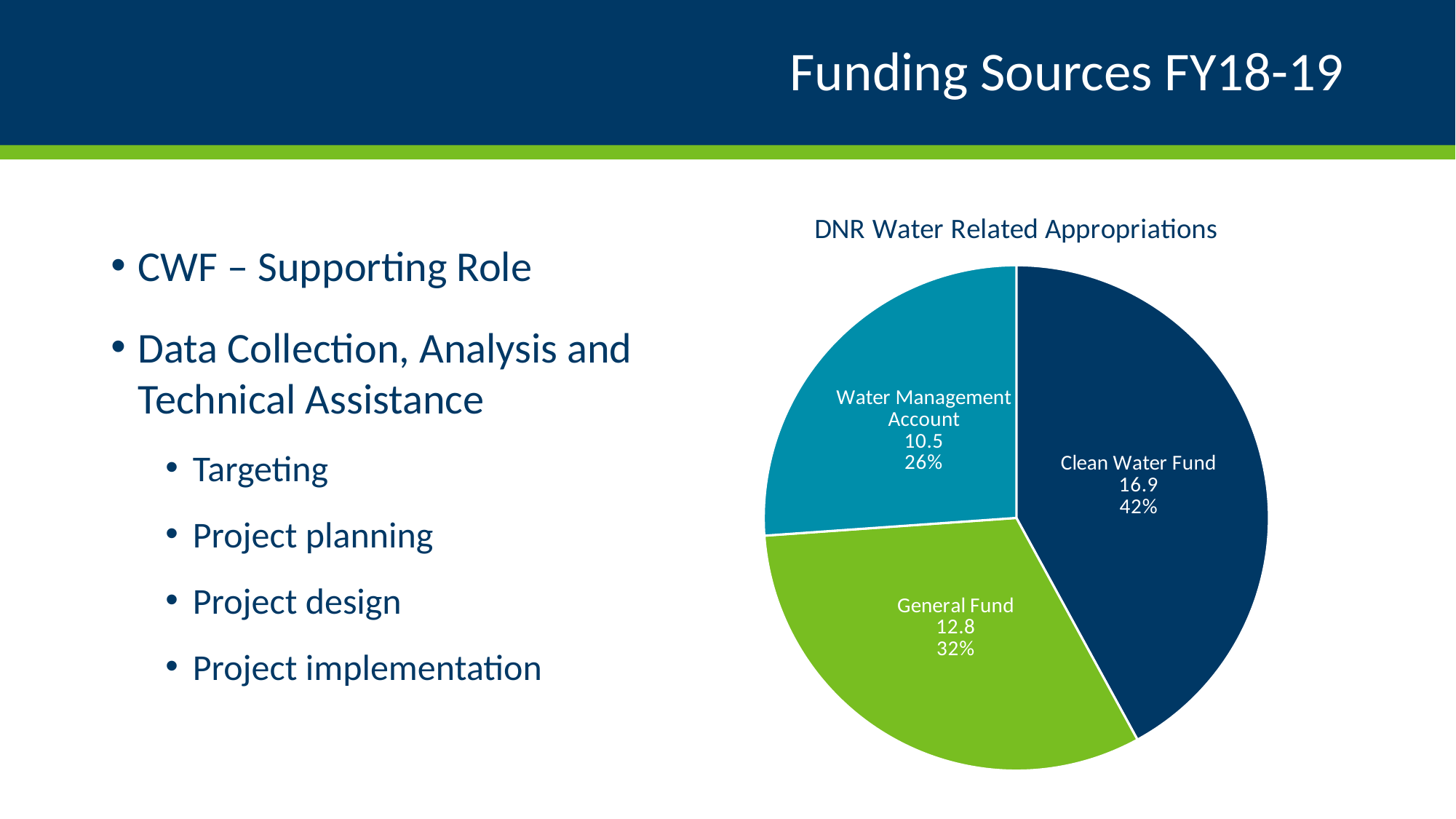
What share of the pie does the General Fund slice represent? 32% What is the value for Clean Water Fund? 16.9 How many slices does the pie chart have? 3 Which category has the largest slice? Clean Water Fund What is the title of the chart? DNR Water Related Appropriations What share of the pie does the Water Management Account slice represent? 26% What kind of chart is shown on the slide? Pie chart What is the value for General Fund? 12.8 What is the difference between the Clean Water Fund value and the General Fund value? 4.1 Which category has the smallest slice? Water Management Account Which is larger, General Fund or Water Management Account? General Fund What is the value for Water Management Account? 10.5